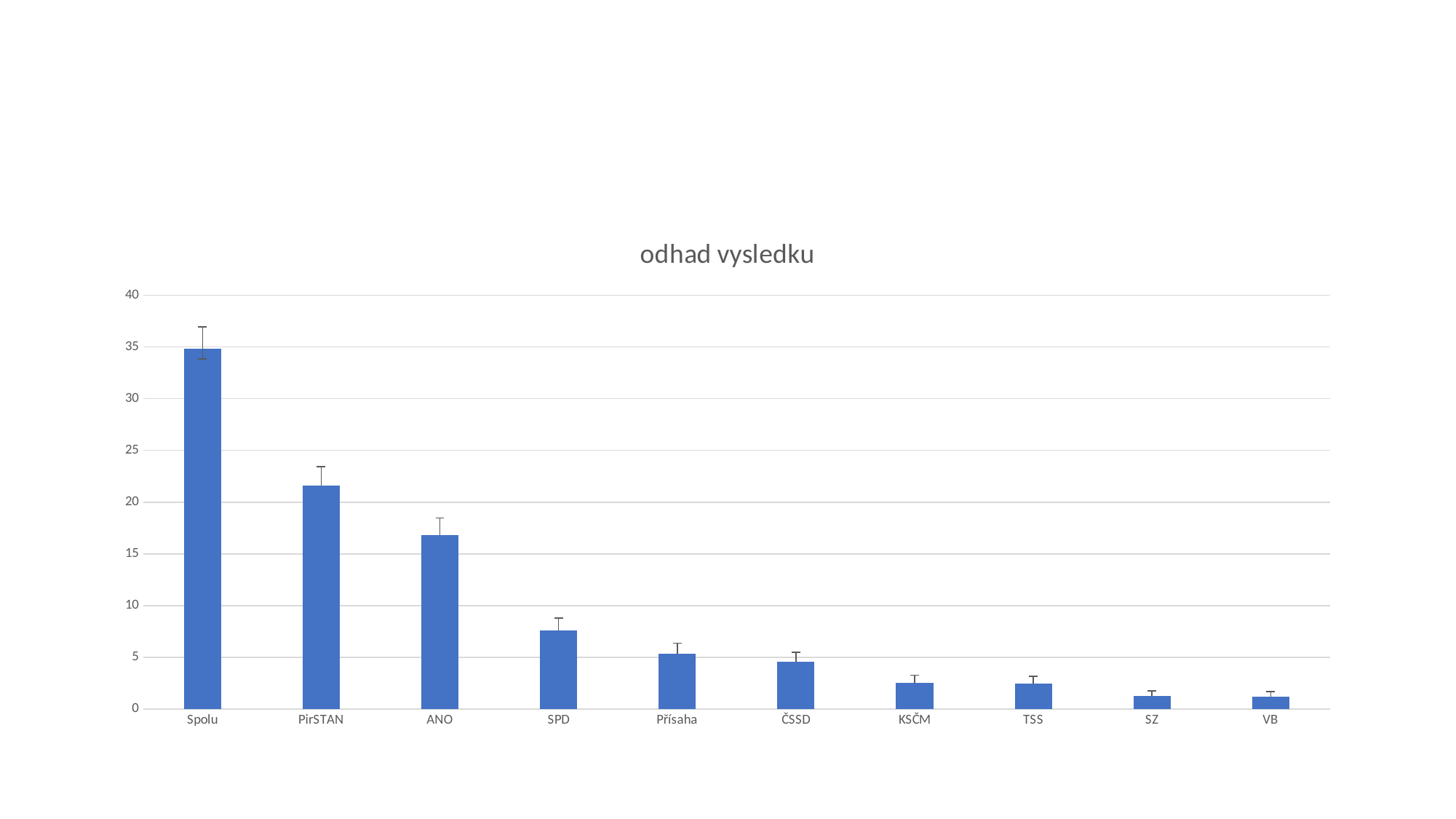
Is the value for PirSTAN greater or less than 25? less Which has a larger value, PirSTAN or ANO? PirSTAN Do the bar values rise or fall from left to right along the x axis? fall What is the title of the chart? odhad vysledku Which category has the highest value in the chart? Spolu What kind of chart is shown on the slide? bar chart Which has a larger value, SPD or ČSSD? SPD Is the value for Spolu greater or less than 30? greater Is the value for SPD greater or less than 10? less How many categories are shown on the x axis of the chart? 10